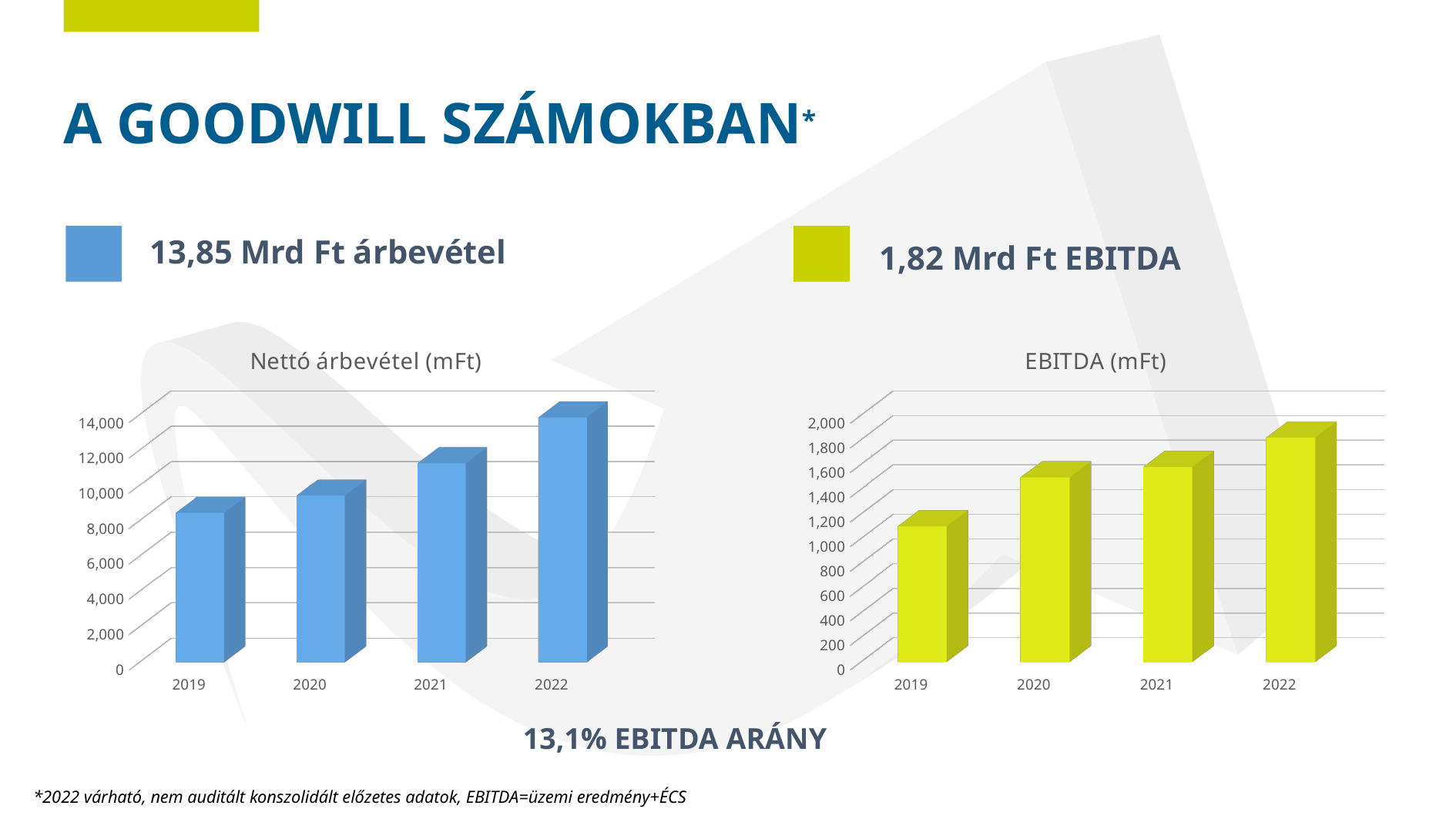
In the 'EBITDA (mFt)' chart, which is larger, the value for 2019 or the value for 2022? 2022 In the 'EBITDA (mFt)' chart, is the value for 2022 greater or less than 1,600? greater In the 'Nettó árbevétel (mFt)' chart, is the value for 2022 greater or less than 12,000? greater In the 'Nettó árbevétel (mFt)' chart, is the value for 2019 greater or less than 12,000? less In the 'Nettó árbevétel (mFt)' chart, which year has the lowest value? 2019 What kind of chart is the 'Nettó árbevétel (mFt)' chart? bar chart In the 'Nettó árbevétel (mFt)' chart, do the values rise or fall from 2019 to 2022? rise In the 'EBITDA (mFt)' chart, which year has the highest value? 2022 In the 'Nettó árbevétel (mFt)' chart, which year has the highest value? 2022 How many years are shown in the 'Nettó árbevétel (mFt)' chart? 4 In the 'EBITDA (mFt)' chart, which year has the lowest value? 2019